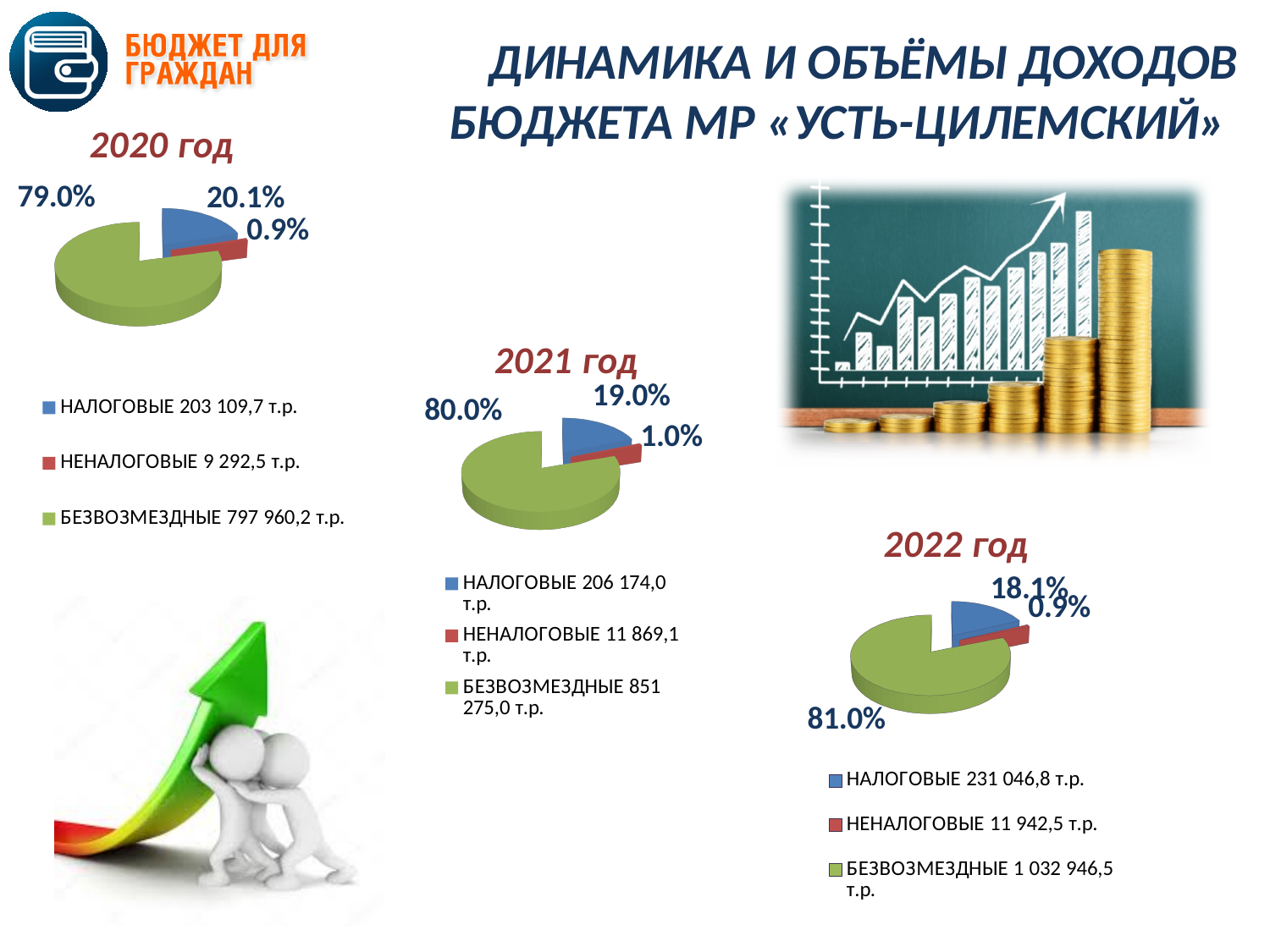
In the "2021 год" chart, which category has the largest slice? БЕЗВОЗМЕЗДНЫЕ In the "2020 год" chart, which category has the smallest slice? НЕНАЛОГОВЫЕ In the "2022 год" chart, what share of the pie is БЕЗВОЗМЕЗДНЫЕ? 81.0% In the "2021 год" chart, what share of the pie is НАЛОГОВЫЕ? 19.0% In the "2021 год" chart, what value does the legend give for НЕНАЛОГОВЫЕ? 11 869,1 т.р. What kind of chart is the "2021 год" chart? Pie chart How many categories does the "2022 год" chart show? 3 In the "2020 год" chart, what is the difference in percentage points between the БЕЗВОЗМЕЗДНЫЕ and НАЛОГОВЫЕ shares? 58.9 percentage points In the "2020 год" chart, what value does the legend give for НАЛОГОВЫЕ? 203 109,7 т.р. In the "2022 год" chart, which is larger, the НАЛОГОВЫЕ slice or the НЕНАЛОГОВЫЕ slice? НАЛОГОВЫЕ In the "2020 год" chart, what share of the pie is БЕЗВОЗМЕЗДНЫЕ? 79.0% In the "2022 год" chart, what value does the legend give for НАЛОГОВЫЕ? 231 046,8 т.р.